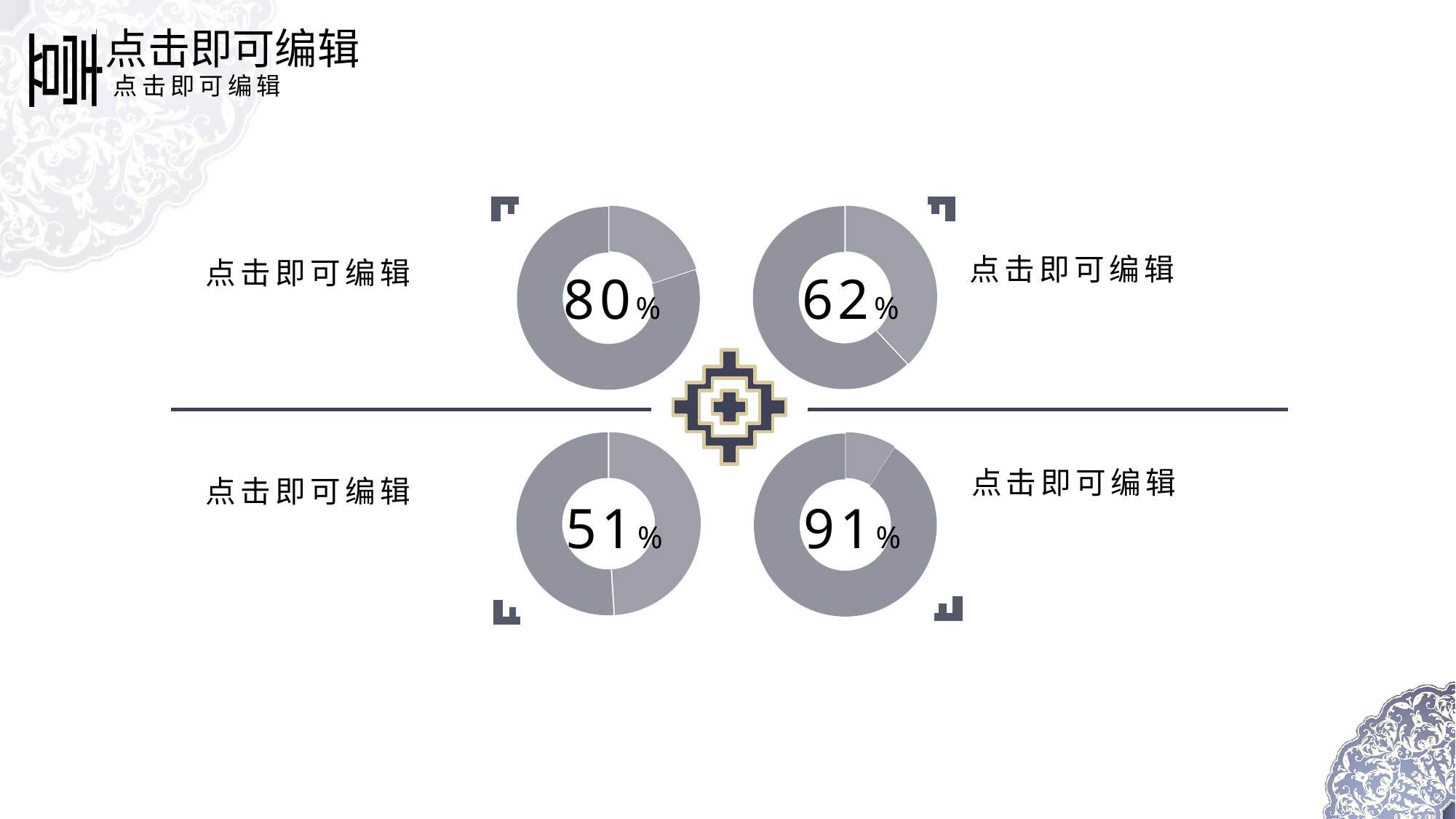
What percentage is shown in the centre of the top-right donut chart? 62% What is the difference between the percentage in the bottom-right donut chart and the percentage in the bottom-left donut chart? 40% What kind of chart is used for each of the four percentages on the slide? donut chart Which shows a larger percentage, the top-right donut chart or the bottom-right donut chart? bottom-right What percentage is shown in the centre of the bottom-left donut chart? 51% What percentage is shown in the centre of the bottom-right donut chart? 91% How many donut charts are on the slide? 4 Which shows a larger percentage, the top-left donut chart or the bottom-left donut chart? top-left What percentage is shown in the centre of the top-left donut chart? 80% What is the difference between the percentage in the top-left donut chart and the percentage in the top-right donut chart? 18% Which of the four donut charts shows the lowest percentage? bottom-left (51%) Which of the four donut charts shows the highest percentage? bottom-right (91%)